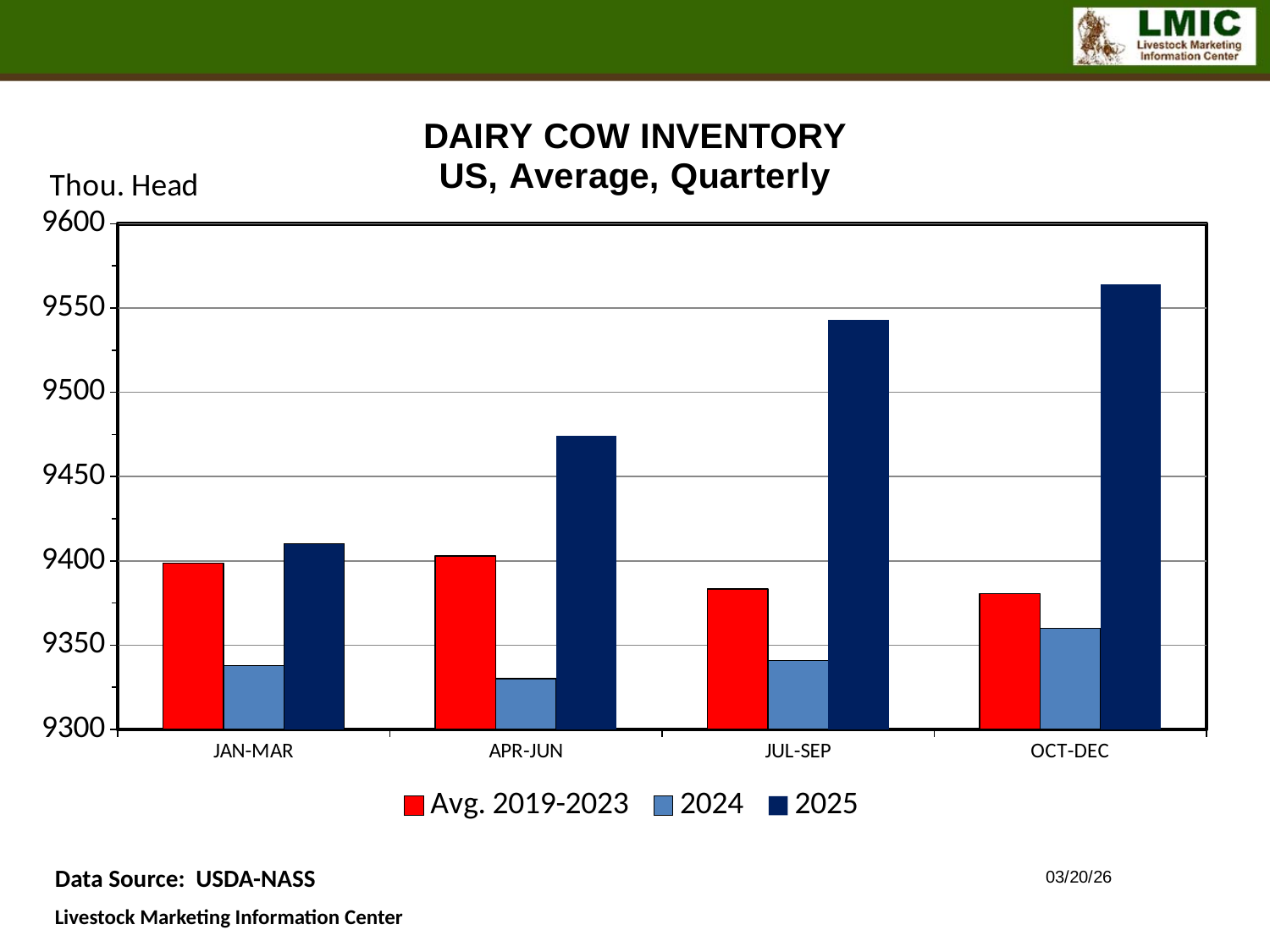
What kind of chart is shown on the slide? bar chart In JAN-MAR, which is larger: the 2024 value or the 2025 value? 2025 Is the Avg. 2019-2023 value for JUL-SEP greater or less than 9400? less Do the 2025 values rise or fall from JAN-MAR to OCT-DEC? rise How many series does the legend list? 3 In OCT-DEC, which is larger: the Avg. 2019-2023 value or the 2024 value? Avg. 2019-2023 Is the 2025 value for JUL-SEP greater or less than 9500? greater In which quarter is the 2025 value highest? OCT-DEC Is the 2024 value for APR-JUN greater or less than 9350? less What unit is shown on the y axis label? Thou. Head In which quarter is the 2025 value lowest? JAN-MAR How many quarterly categories are shown on the x axis? 4